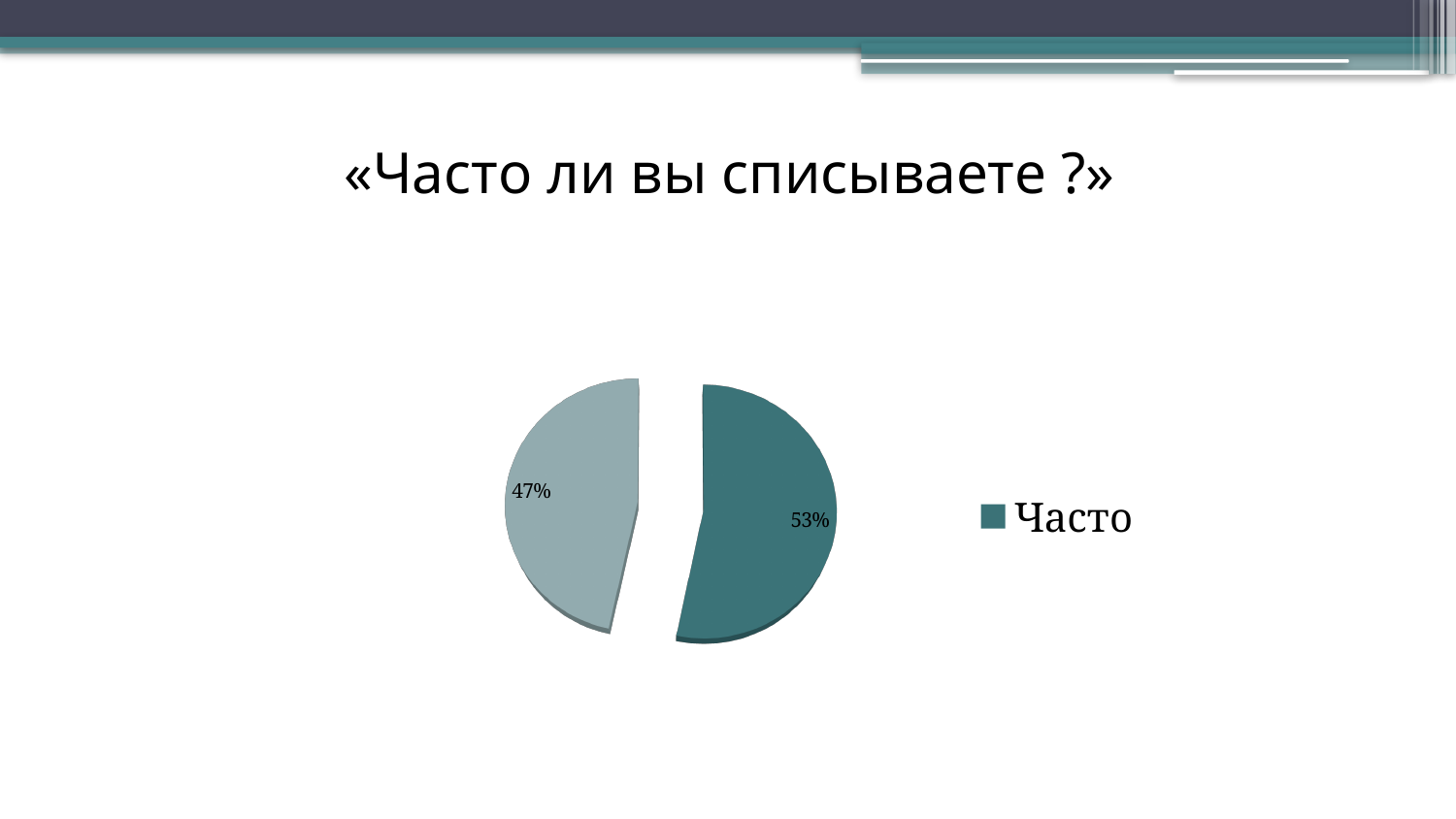
What kind of chart is shown on the slide? pie chart Which legend entry is shown next to the pie chart? Часто What is the value of the smallest slice in the pie chart? 47% How many entries does the legend list? 1 What is the value of the largest slice in the pie chart? 53% Is the share of the "Часто" slice greater or less than 50%? greater Is the "Часто" slice larger or smaller than the other slice? larger How many slices does the pie chart have? 2 What share of the pie does the "Часто" slice represent? 53% What is the title shown above the chart? «Часто ли вы списываете ?» What is the difference in percentage points between the two slices of the pie chart? 6